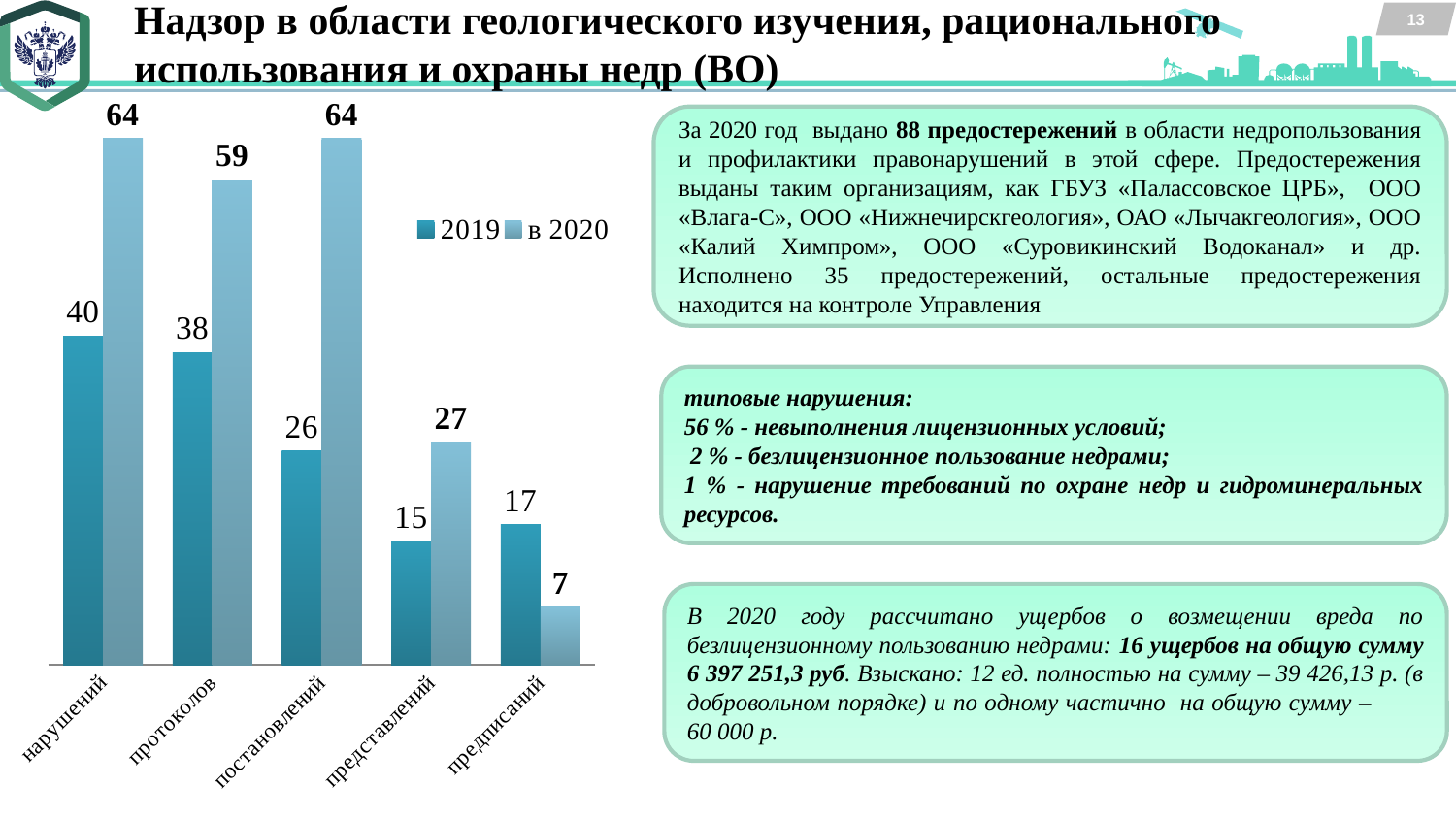
Какое значение показано для категории «протоколов» в серии «2019»? 38 Что больше для категории «предписаний»: значение «2019» или «в 2020»? 2019 Какие серии перечислены в легенде диаграммы? 2019 и в 2020 Какого типа эта диаграмма? столбчатая (bar chart) Сколько категорий показано на оси X диаграммы? 5 Какое значение показано для категории «представлений» в серии «2019»? 15 Какое значение показано для категории «предписаний» в серии «в 2020»? 7 В какой категории значение серии «в 2020» наименьшее? предписаний Сколько серий перечислено в легенде диаграммы? 2 В какой категории значение серии «2019» наибольшее? нарушений На сколько значение «в 2020» для категории «протоколов» больше значения «2019» для этой же категории? 21 Какое значение показано для категории «нарушений» в серии «в 2020»? 64